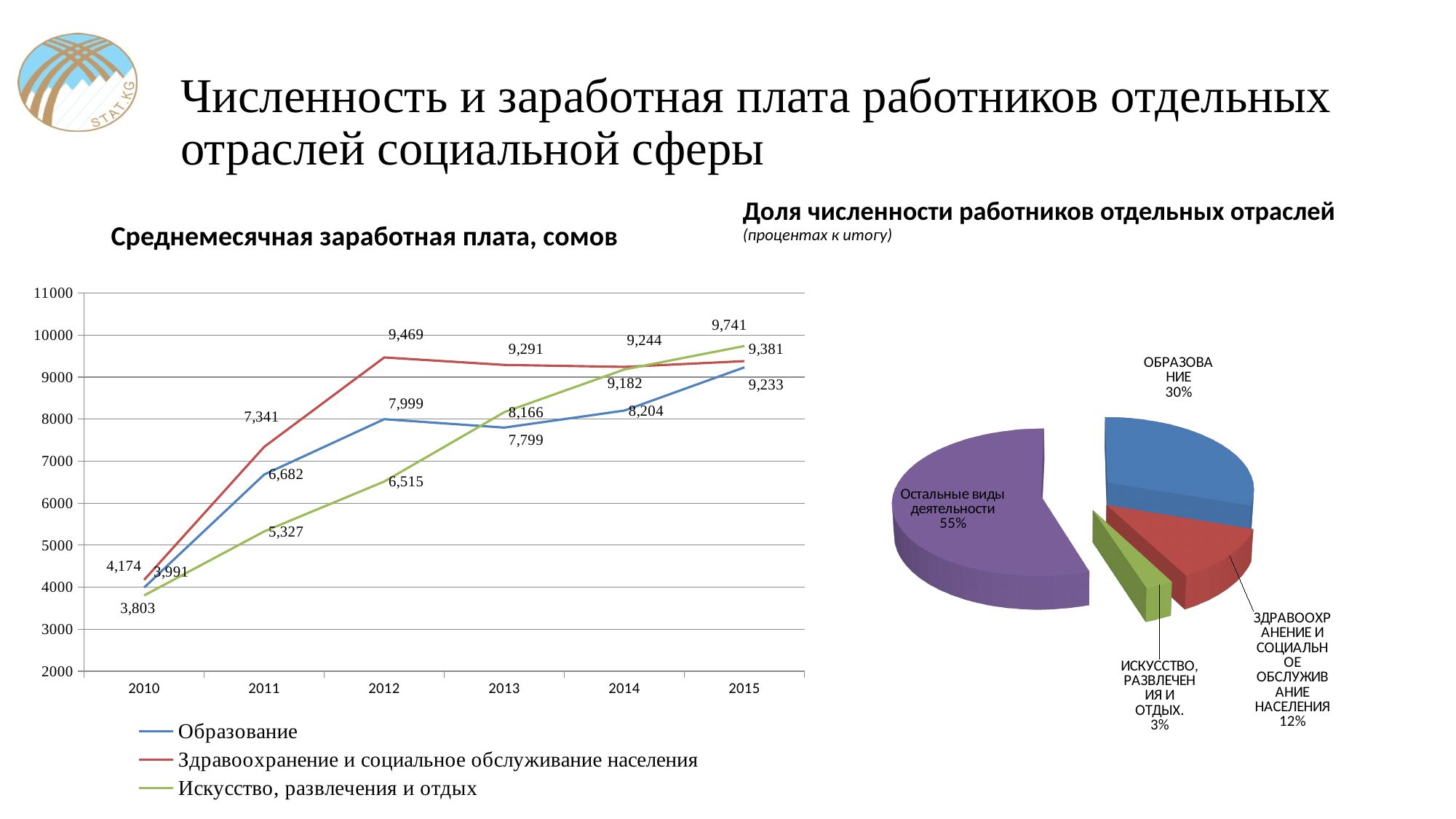
In the chart 'Среднемесячная заработная плата, сомов', how many series does the legend list? 3 What kind of chart is the chart on the right of the slide? pie chart In the chart 'Среднемесячная заработная плата, сомов', what was the value for Образование in 2012? 7,999 In the chart 'Среднемесячная заработная плата, сомов', what is the difference between the 2015 and 2010 values for Образование? 5,242 In the chart 'Среднемесячная заработная плата, сомов', what was the value for Искусство, развлечения и отдых in 2015? 9,741 In the chart 'Среднемесячная заработная плата, сомов', does the value for Искусство, развлечения и отдых rise or fall from 2010 to 2015? rise In the chart 'Среднемесячная заработная плата, сомов', which was larger in 2013: Образование or Искусство, развлечения и отдых? Искусство, развлечения и отдых In the chart 'Среднемесячная заработная плата, сомов', in which year did Здравоохранение и социальное обслуживание населения reach its highest value? 2012 In the chart 'Среднемесячная заработная плата, сомов', which series had the lowest value in 2010? Искусство, развлечения и отдых In the chart 'Среднемесячная заработная плата, сомов', how many years are shown on the x axis? 6 In the pie chart 'Доля численности работников отдельных отраслей', what share does Образование have? 30% In the chart 'Среднемесячная заработная плата, сомов', what was the value for Здравоохранение и социальное обслуживание населения in 2010? 4,174